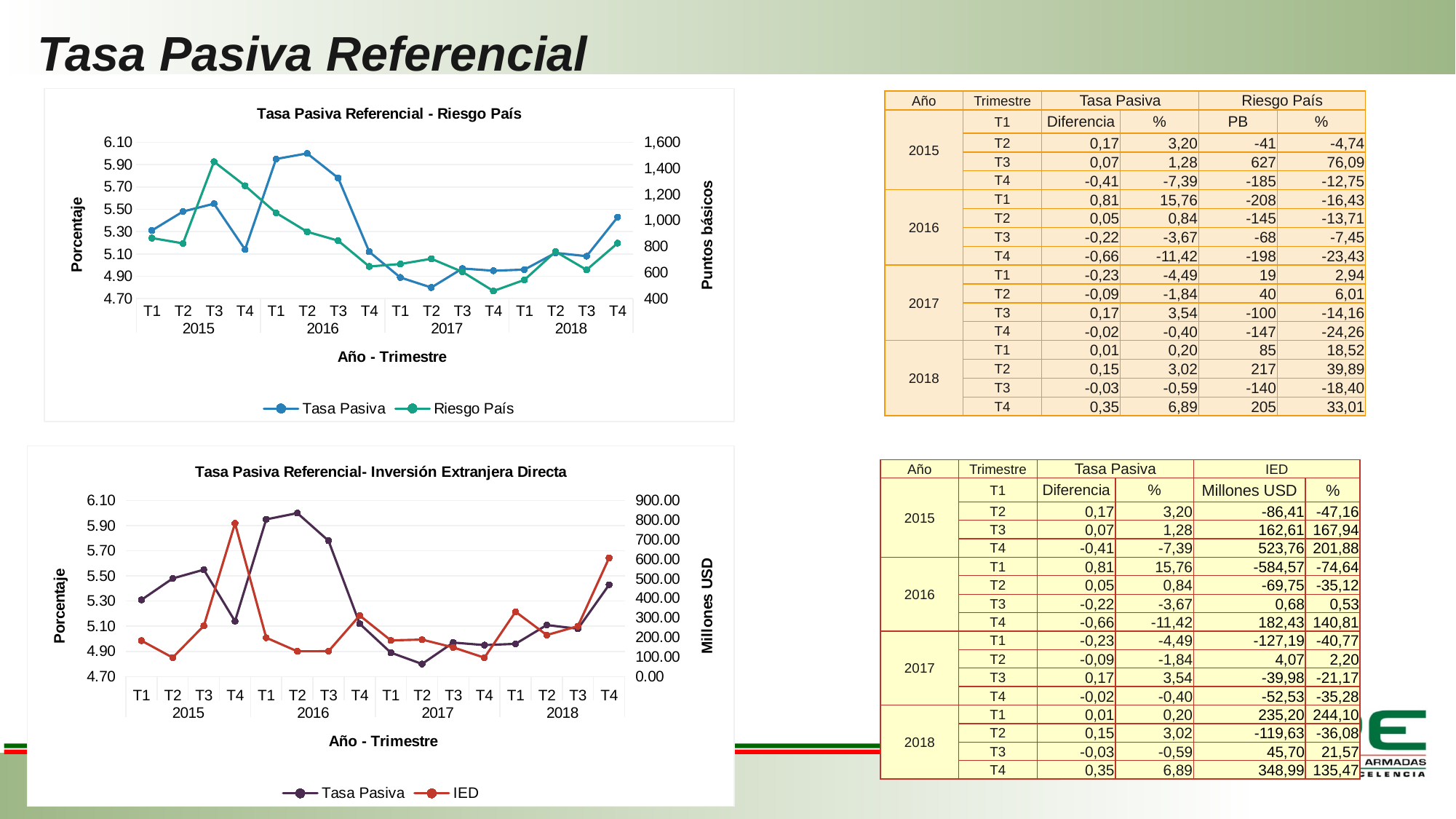
How many series does the legend of the top chart 'Tasa Pasiva Referencial - Riesgo País' list? 2 In the bottom chart 'Tasa Pasiva Referencial- Inversión Extranjera Directa', in which quarter does the IED series reach its highest value? T4 2015 In the top chart 'Tasa Pasiva Referencial - Riesgo País', in which quarter does the Riesgo País series reach its highest value? T3 2015 In the top chart 'Tasa Pasiva Referencial - Riesgo País', how many quarterly points are plotted for each series? 16 What type of chart is the top chart titled 'Tasa Pasiva Referencial - Riesgo País'? line chart In the top chart 'Tasa Pasiva Referencial - Riesgo País', in which quarter does the Tasa Pasiva series reach its highest value? T2 2016 In the top chart 'Tasa Pasiva Referencial - Riesgo País', is the Tasa Pasiva value for T2 2017 greater or less than 4.90? less In the bottom chart 'Tasa Pasiva Referencial- Inversión Extranjera Directa', is the IED value for T4 2015 greater or less than 700.00 millones USD? greater What is the label of the right-hand vertical axis of the bottom chart 'Tasa Pasiva Referencial- Inversión Extranjera Directa'? Millones USD In the top chart 'Tasa Pasiva Referencial - Riesgo País', in which quarter does the Tasa Pasiva series reach its lowest value? T2 2017 In the top chart 'Tasa Pasiva Referencial - Riesgo País', is the Riesgo País value for T3 2015 greater or less than 1,200 puntos básicos? greater In the top chart 'Tasa Pasiva Referencial - Riesgo País', does the Tasa Pasiva series rise or fall from T2 2016 to T2 2017? fall